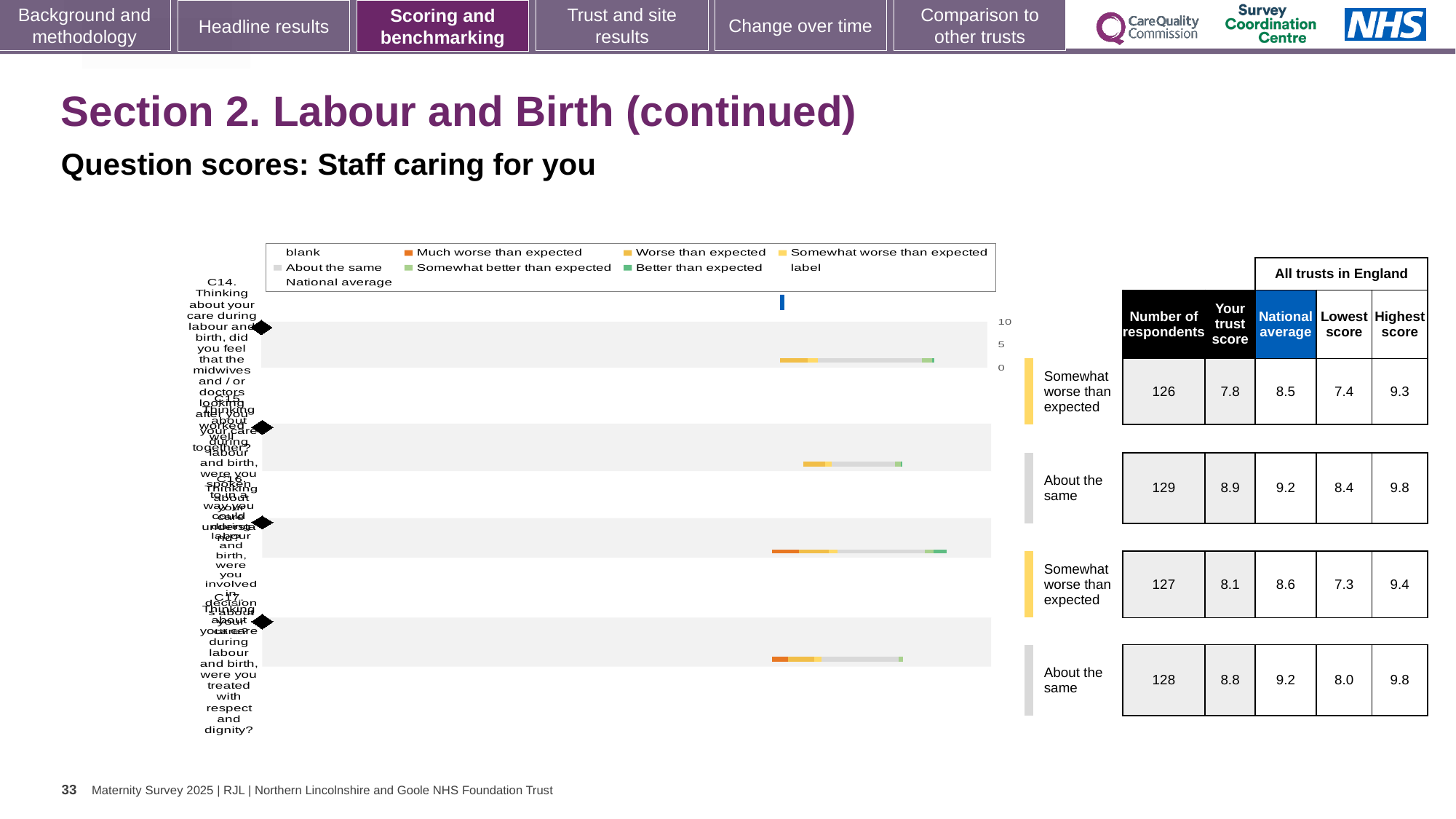
How many entries does the chart's legend list? 9 In the table beside the chart, what is the difference between the national average and the trust score for the first row (C14)? 0.7 In the table beside the chart, what is the number of respondents for the third row (C16)? 127 In the table beside the chart, which row has the lowest trust score? first row (C14), 7.8 In the table beside the chart, what is the highest score for the fourth row (C17)? 9.8 How many question rows (bars) does the chart show? 4 In the table beside the chart, which row has the highest trust score? second row (C15), 8.9 What kind of chart is shown on the slide? bar chart What is the first entry in the chart's legend? blank In the table beside the chart, what is the trust score for the first row (C14)? 7.8 Which legend entry is shown in orange? Much worse than expected In the table beside the chart, what is the national average for the second row (C15)? 9.2